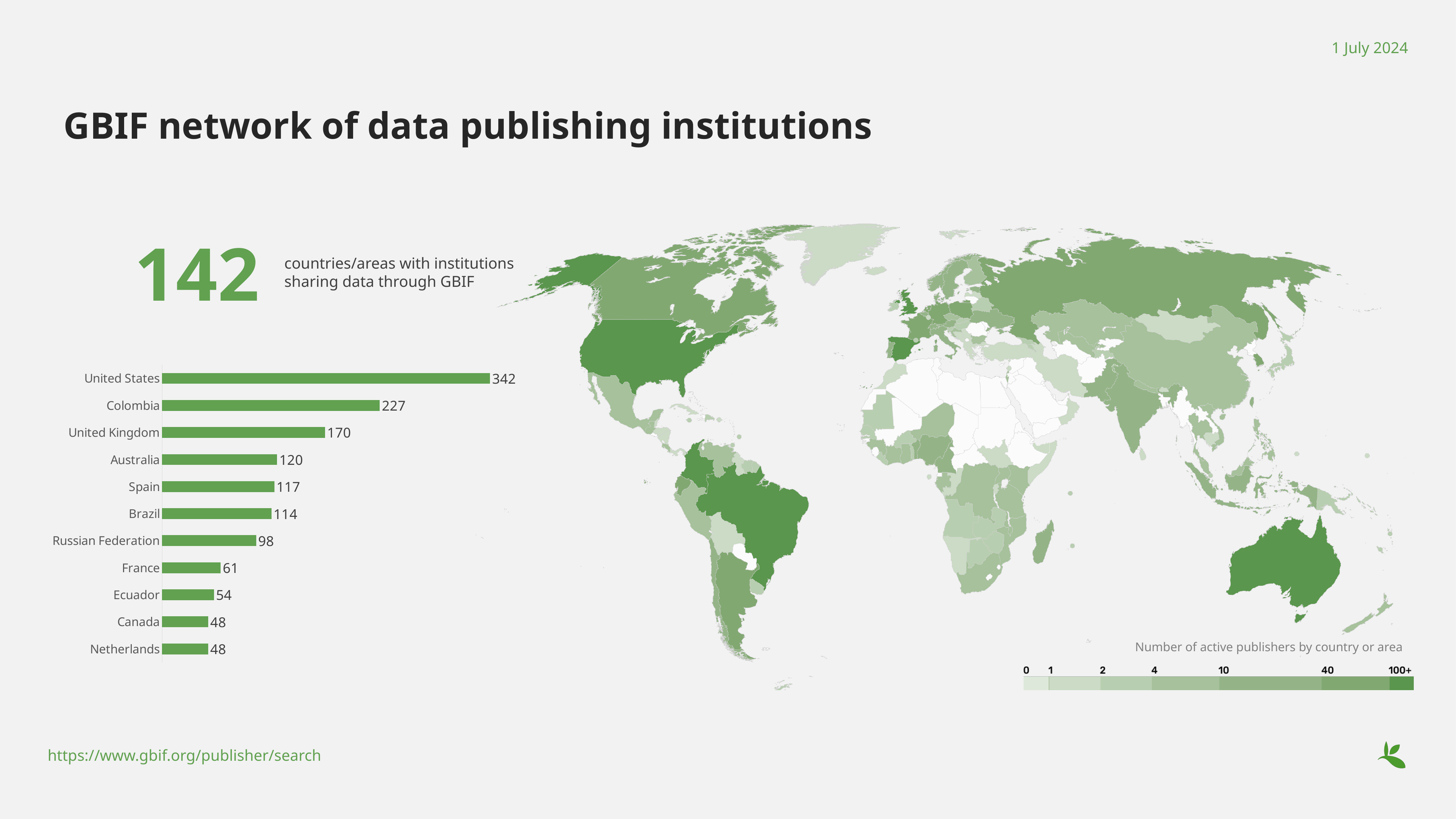
In the bar chart, which is larger, the value for France or the value for Ecuador? France In the bar chart, which country has the highest number of active publishers? United States In the bar chart, what is the difference between the values for the United States and Colombia? 115 In the bar chart, which two countries share the same value of 48? Canada and Netherlands In the bar chart, which is larger, the value for the United Kingdom or the value for Brazil? United Kingdom In the bar chart, what is the value for Colombia? 227 In the bar chart, how many active publishers does the United States have? 342 In the bar chart, what is the value for the Russian Federation? 98 What kind of chart is used on the left of the slide to show publishers by country? Bar chart According to the slide, how many countries/areas have institutions sharing data through GBIF? 142 In the bar chart, what is the difference between the values for Australia and Spain? 3 How many countries are listed in the bar chart? 11